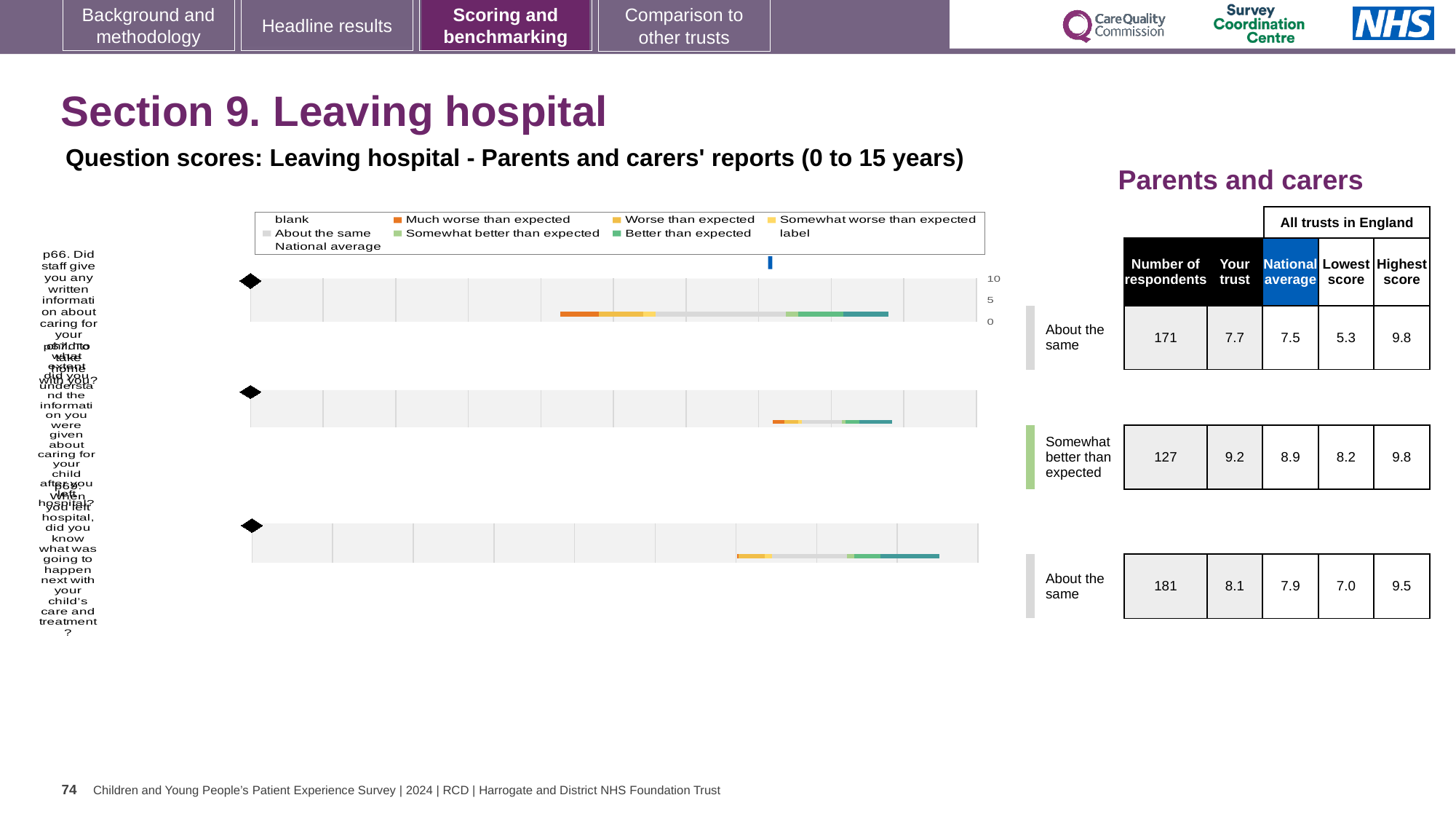
For the third (bottom) question row, what is the national average shown in the table? 7.9 For the second (middle) question row, what is the 'Your trust' score shown in the table? 9.2 How many question rows (charts) are plotted on the slide? 3 Which question row has the highest 'Your trust' score? the second (middle) row For the third (bottom) question row, is the 'Your trust' score or the national average larger? Your trust For the first (top) question row, what is the 'Your trust' score shown in the table? 7.7 What is the difference between the 'Your trust' score and the national average for the first (top) question row? 0.2 What kind of chart is used to show the question scores on this slide? bar chart What benchmark category is the second (middle) question row assigned? Somewhat better than expected For the second (middle) question row, how many respondents are shown? 127 Which question row has the lowest 'Your trust' score? the first (top) row